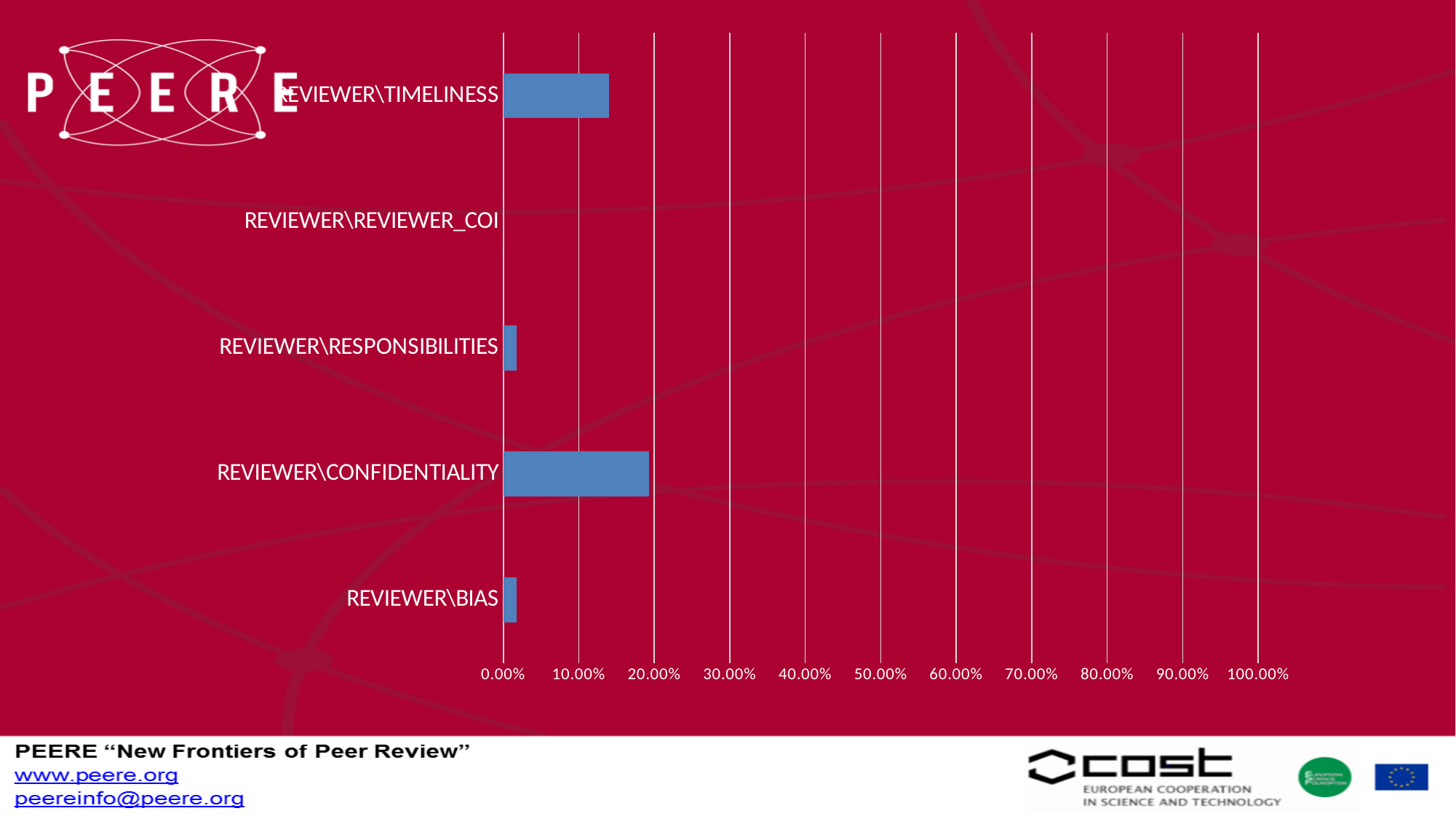
Is the value for REVIEWER\CONFIDENTIALITY greater or less than 10.00%? greater Which has the larger value, REVIEWER\TIMELINESS or REVIEWER\BIAS? REVIEWER\TIMELINESS Is the value for REVIEWER\TIMELINESS greater or less than 10.00%? greater Which category has the highest value in the chart? REVIEWER\CONFIDENTIALITY Is the value for REVIEWER\BIAS greater or less than 10.00%? less Which category has the lowest value in the chart? REVIEWER\REVIEWER_COI What is the maximum value shown on the horizontal axis of the chart? 100.00% How many categories are plotted in the chart? 5 What kind of chart is shown on the slide? bar chart Which has the larger value, REVIEWER\TIMELINESS or REVIEWER\CONFIDENTIALITY? REVIEWER\CONFIDENTIALITY